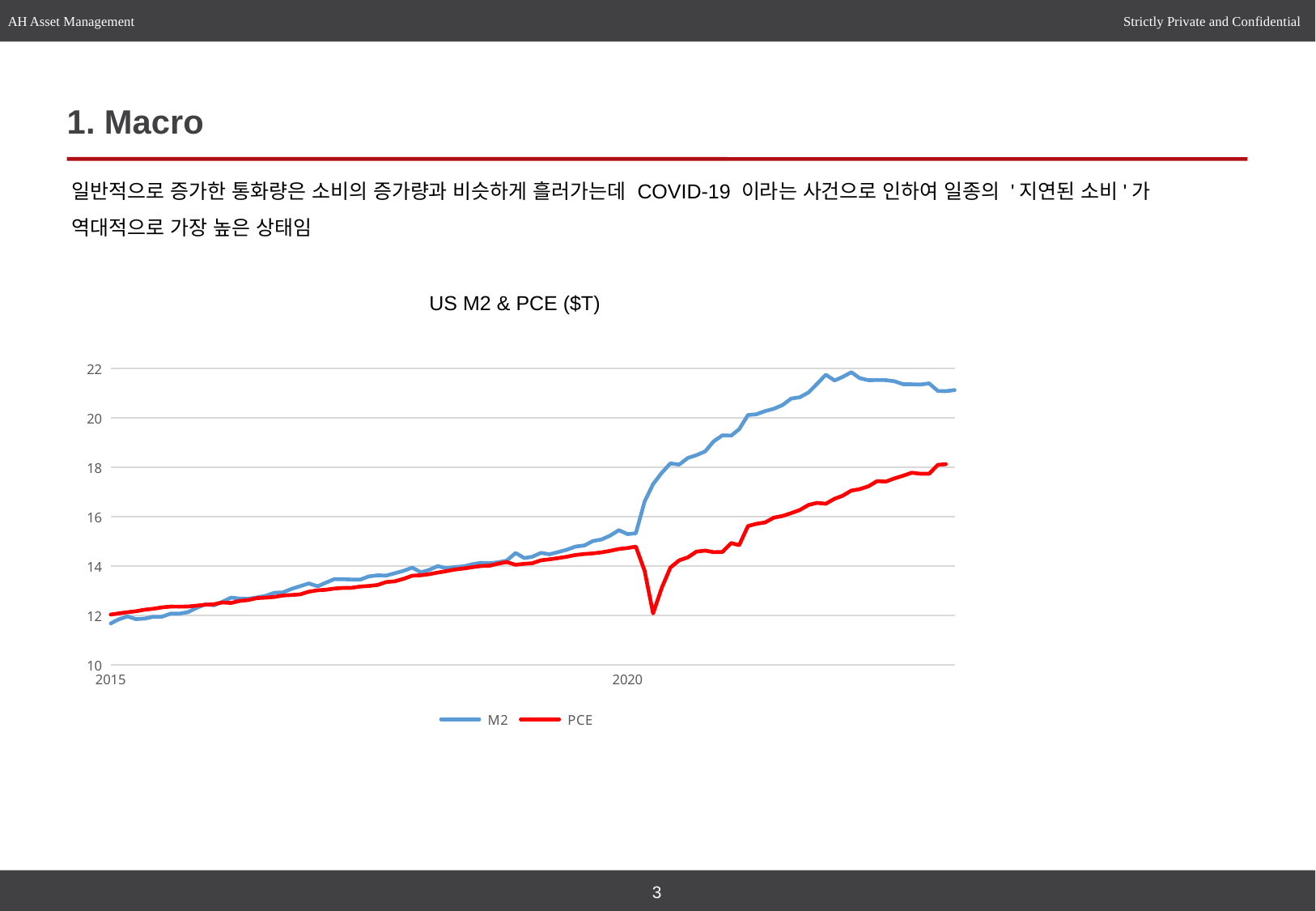
What kind of chart is shown on the slide? line chart Which series shows a sharp drop around 2020? PCE Is the final value of the PCE line greater or less than 20? less Is the starting value of the M2 line in 2015 greater or less than 12? less How many series does the legend list? 2 Does the M2 line generally rise or fall from 2015 to the end of the chart? rise Is the final value of the M2 line greater or less than 20? greater What is the title of the chart? US M2 & PCE ($T) At the right end of the chart, which series is higher, M2 or PCE? M2 Which colour is used for the PCE line? red